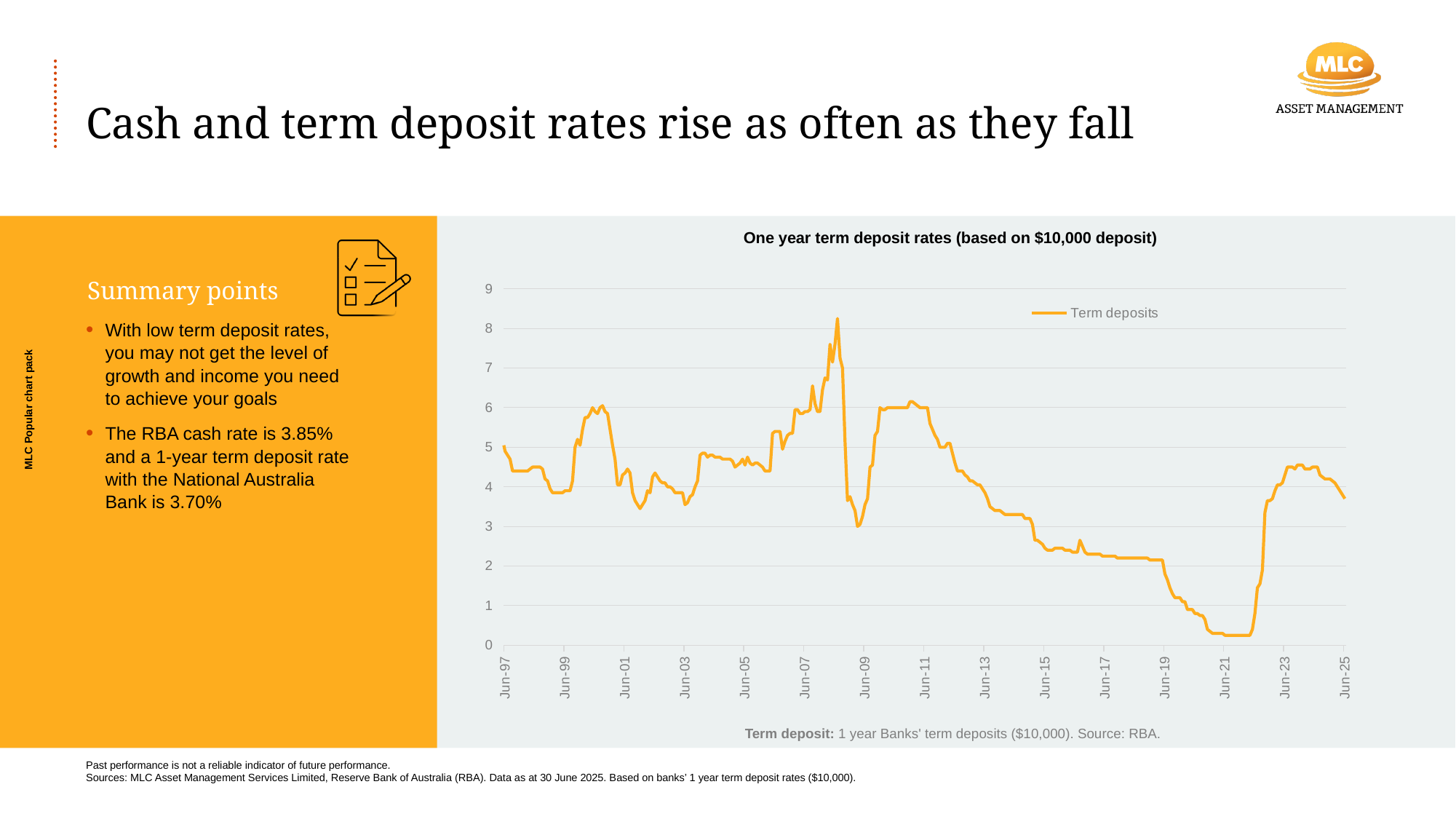
Is the term deposit rate at Jun-23 greater or less than 4? greater How many series does the chart legend list? 1 What is the name of the series shown in the chart legend? Term deposits Is the term deposit rate at Jun-21 greater or less than 1? less How many date labels are shown on the x axis? 15 Is the term deposit rate at Jun-17 greater or less than 3? less What kind of chart is shown on the slide? Line chart Between Jun-11 and Jun-21, does the term deposit rate generally rise or fall? fall Between Jun-21 and Jun-23, does the term deposit rate rise or fall? rise What is the title of the chart? One year term deposit rates (based on $10,000 deposit)